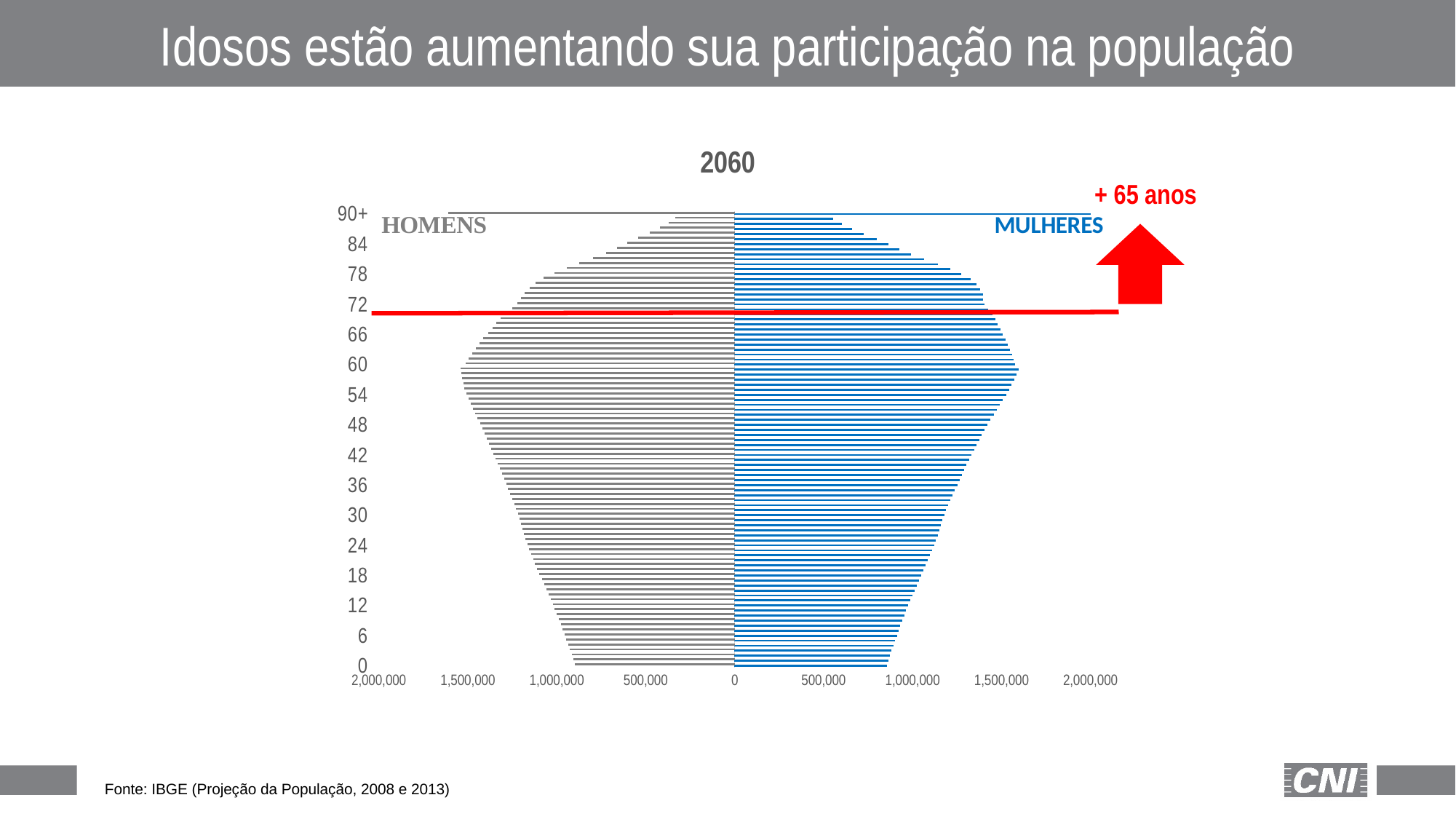
What is the title of the chart? 2060 Is the value for HOMENS at age 90+ greater or less than 500,000? greater Is the value for HOMENS at age 0 greater or less than 1,000,000? less Is the value for HOMENS at age 60 greater or less than 1,000,000? greater For HOMENS, is the bar at age 60 longer or shorter than the bar at age 0? longer Which series is plotted in blue? MULHERES How many series does the chart show? 2 What kind of chart is shown on the slide? Bar chart (population pyramid)